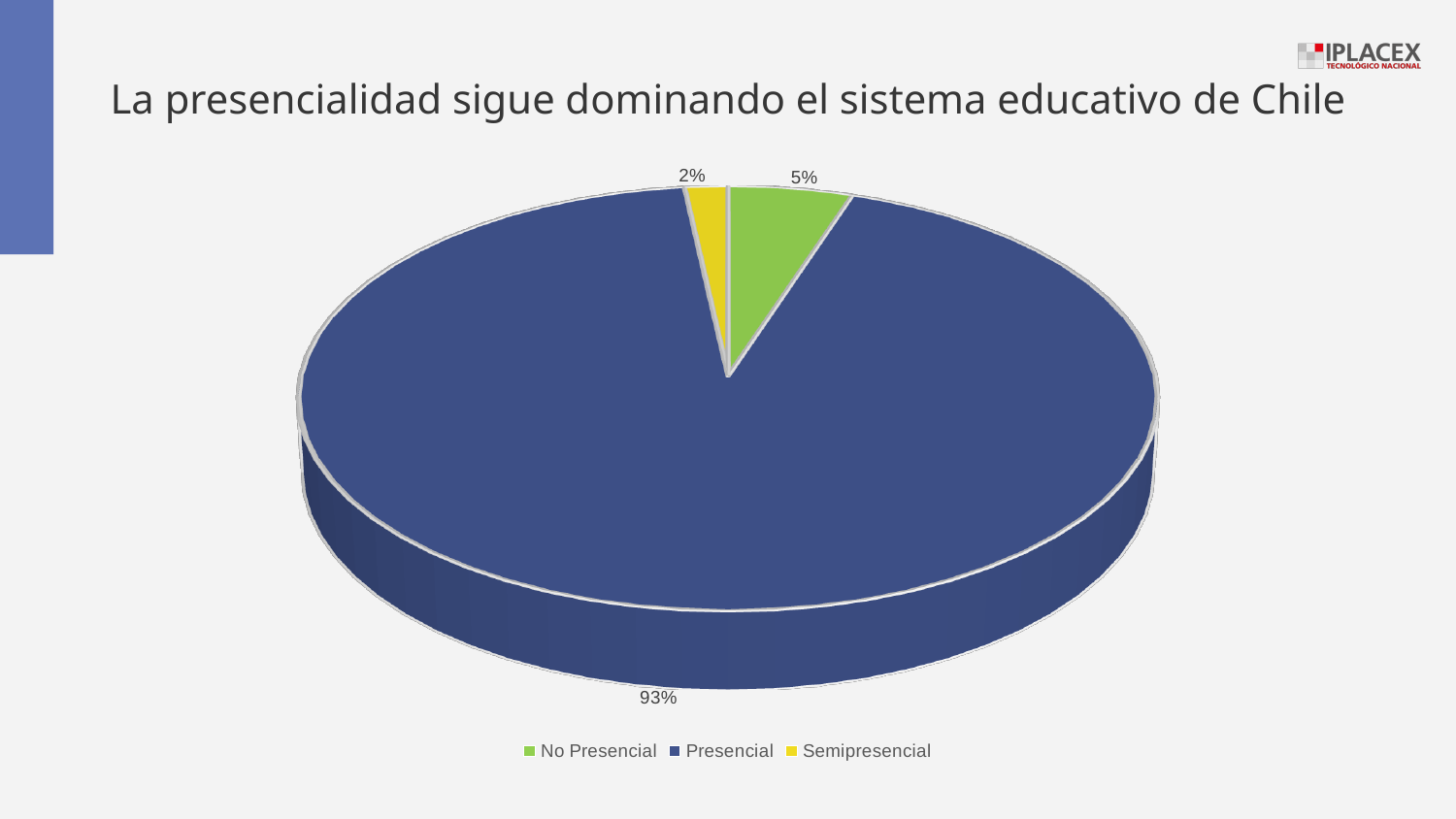
What is the difference in percentage points between No Presencial and Semipresencial? 3 How many categories does the pie chart have? 3 What share of the pie does Presencial have? 93% What is the title of the slide above the chart? La presencialidad sigue dominando el sistema educativo de Chile Which category has the smallest slice of the pie? Semipresencial What colour is the Presencial slice? blue Which category has the largest slice of the pie? Presencial What kind of chart is shown on the slide? pie chart What share of the pie does No Presencial have? 5% Which is larger, the slice for No Presencial or the slice for Semipresencial? No Presencial What is the difference in percentage points between Presencial and No Presencial? 88 What share of the pie does Semipresencial have? 2%